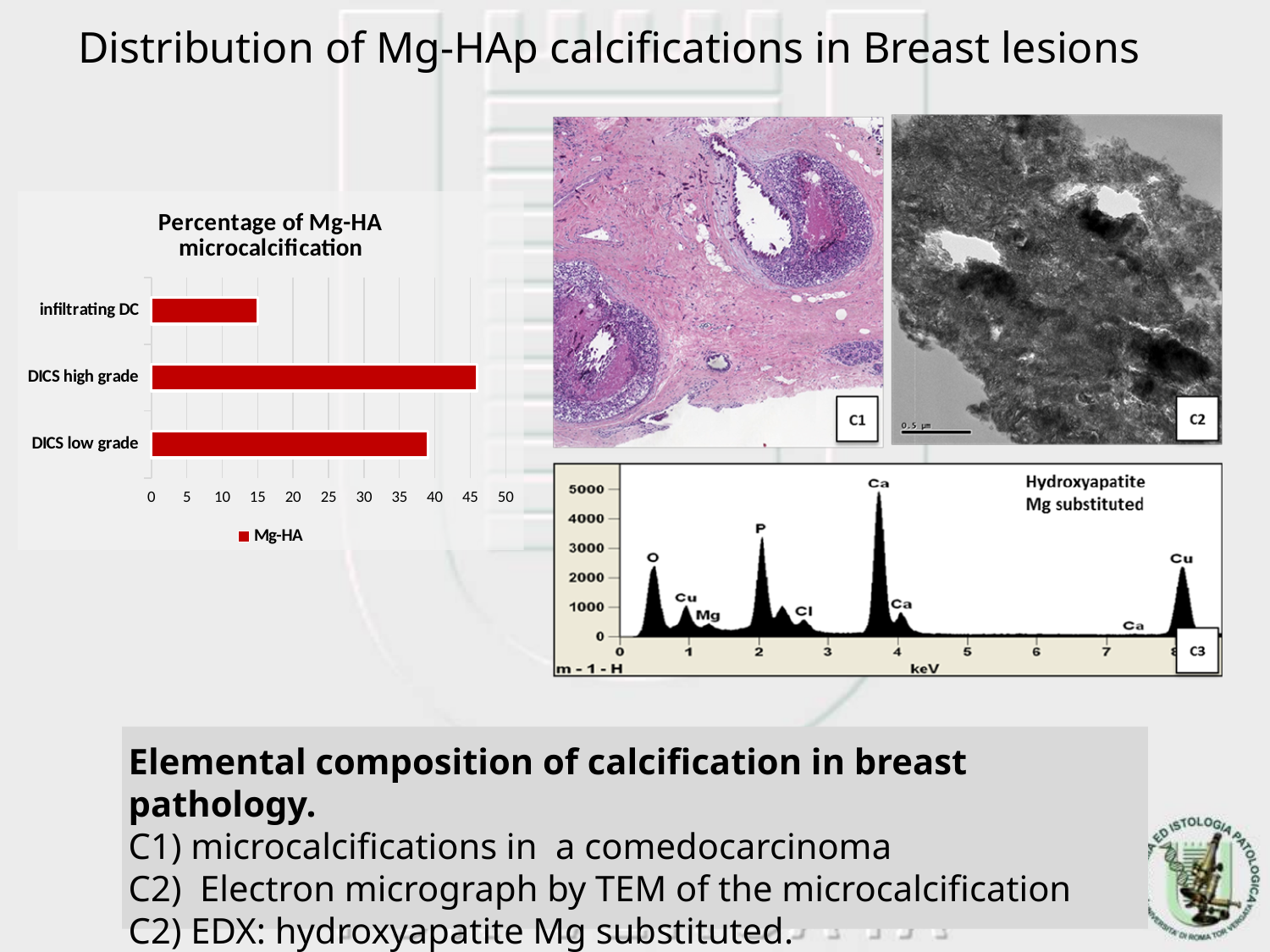
In the 'Percentage of Mg-HA microcalcification' chart, is the value for DICS high grade greater or less than 40? greater What is the name of the series in the legend of the 'Percentage of Mg-HA microcalcification' chart? Mg-HA In the 'Percentage of Mg-HA microcalcification' chart, which is larger: the value for DICS high grade or DICS low grade? DICS high grade How many series does the legend of the 'Percentage of Mg-HA microcalcification' chart list? 1 In the 'Percentage of Mg-HA microcalcification' chart, which is larger: the value for infiltrating DC or DICS low grade? DICS low grade In the 'Percentage of Mg-HA microcalcification' chart, is the value for infiltrating DC greater or less than 20? less How many categories are shown in the 'Percentage of Mg-HA microcalcification' chart? 3 In the EDX spectrum chart (C3) at the lower right, which element has the tallest peak? Ca In the 'Percentage of Mg-HA microcalcification' chart, is the value for DICS low grade greater or less than 35? greater In the 'Percentage of Mg-HA microcalcification' chart, which category has the lowest value? infiltrating DC What kind of chart is the 'Percentage of Mg-HA microcalcification' chart? bar chart In the 'Percentage of Mg-HA microcalcification' chart, which category has the highest value? DICS high grade